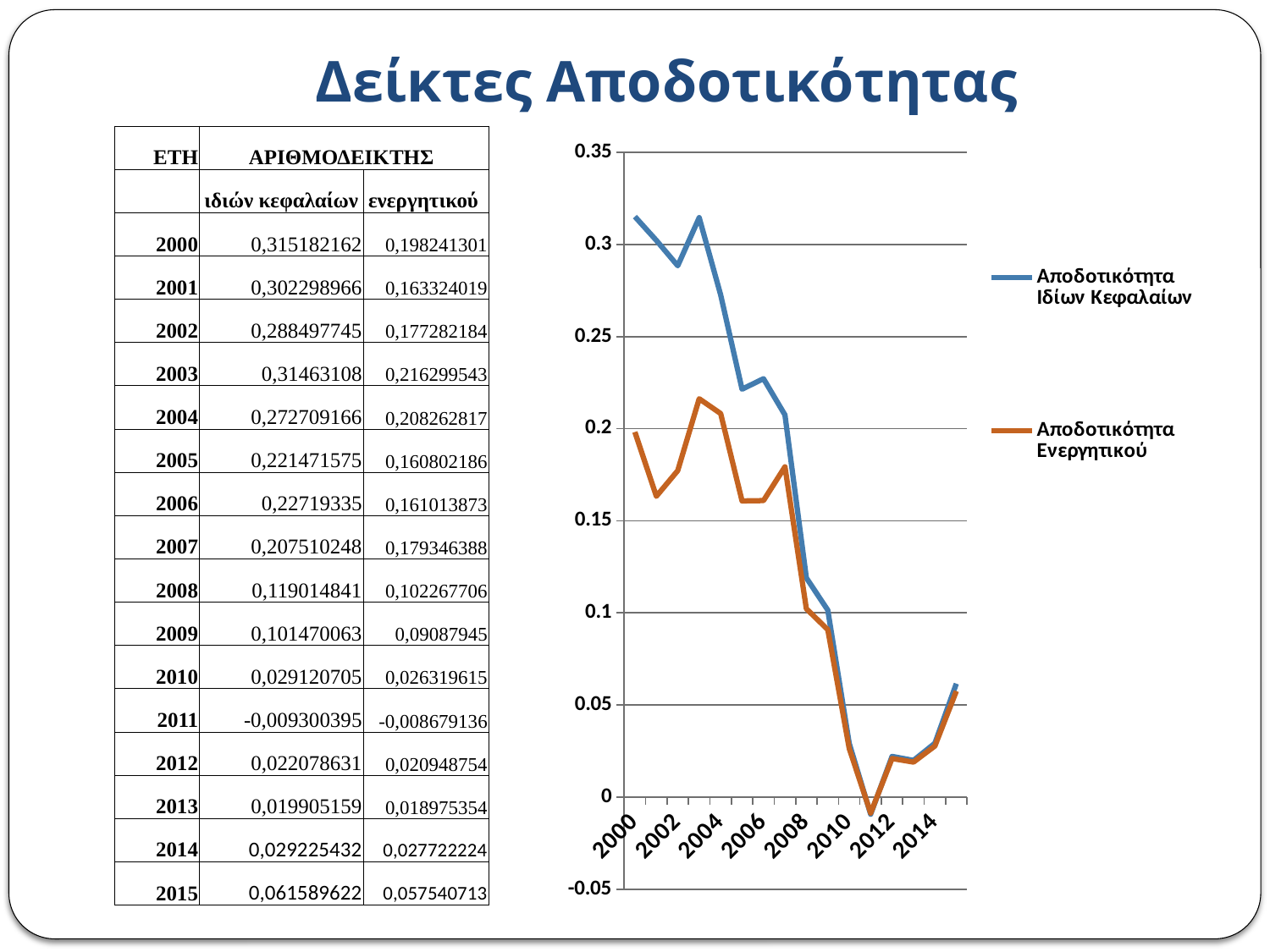
According to the table, what is the value of the ιδίων κεφαλαίων ratio for 2015? 0,061589622 According to the table, what is the value of the ενεργητικού ratio for 2011? -0,008679136 Overall, do the values of Αποδοτικότητα Ιδίων Κεφαλαίων rise or fall from 2000 to 2010? Fall How many series does the chart's legend list? 2 In which year do both series reach their lowest value? 2011 In 2008, which series has the higher value, Αποδοτικότητα Ιδίων Κεφαλαίων or Αποδοτικότητα Ενεργητικού? Αποδοτικότητα Ιδίων Κεφαλαίων What are the two series named in the chart's legend? Αποδοτικότητα Ιδίων Κεφαλαίων and Αποδοτικότητα Ενεργητικού Is the value for Αποδοτικότητα Ενεργητικού in 2005 greater or less than 0.15? greater What kind of chart is shown on the slide? Line chart Is the value for Αποδοτικότητα Ιδίων Κεφαλαίων in 2000 greater or less than 0.3? greater Is the value for Αποδοτικότητα Ιδίων Κεφαλαίων in 2010 greater or less than 0.05? less How many years are plotted along the x axis of the chart? 16